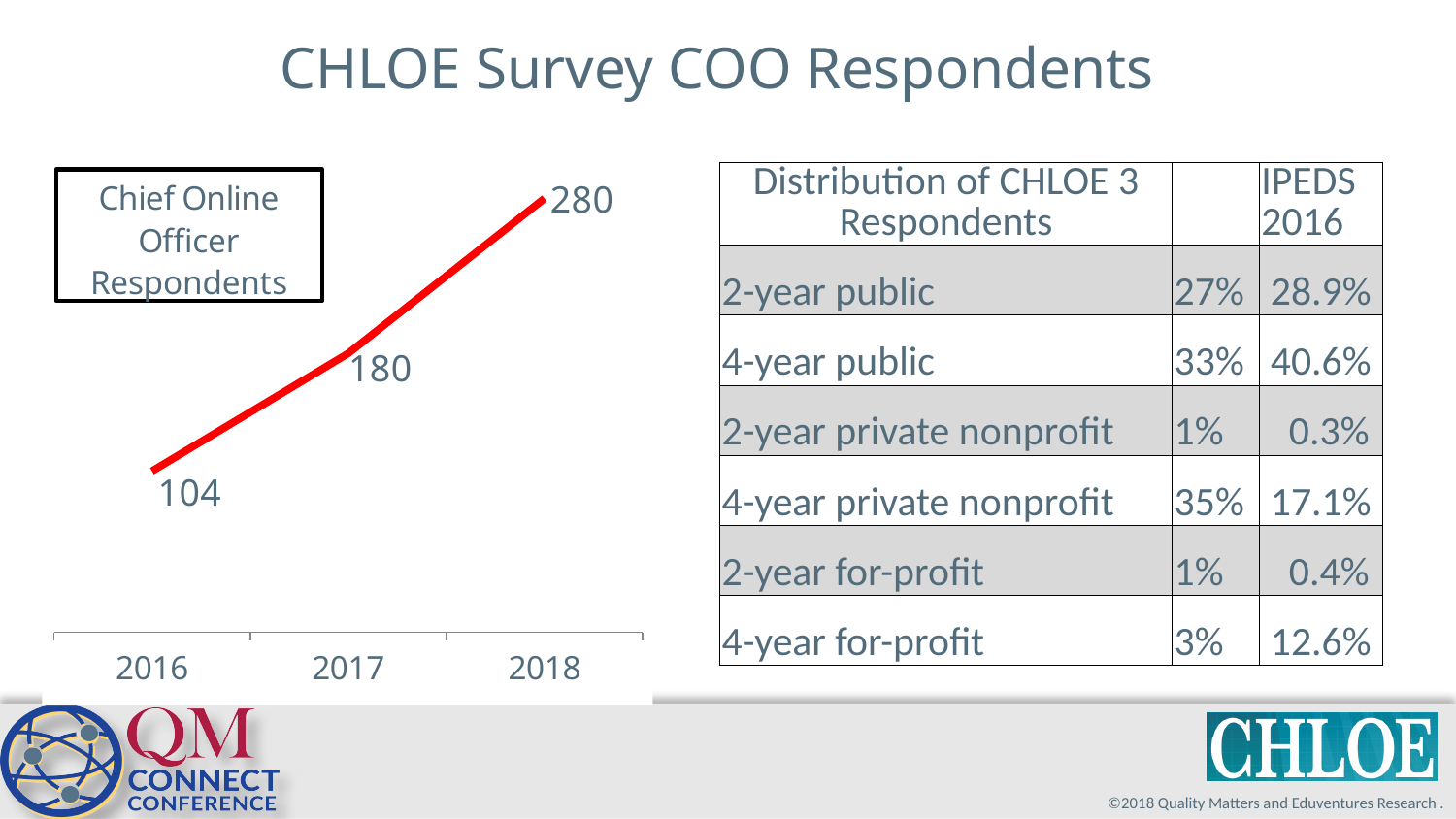
What is the value for 2018 in the Chief Online Officer Respondents chart? 280 How many years are plotted in the Chief Online Officer Respondents chart? 3 Which year has the lowest number of Chief Online Officer respondents? 2016 Do the values in the Chief Online Officer Respondents chart rise or fall from 2016 to 2018? rise What is the value for 2016 in the Chief Online Officer Respondents chart? 104 What is the difference between the 2017 and 2016 values in the Chief Online Officer Respondents chart? 76 What kind of chart is the Chief Online Officer Respondents chart? line chart Which year has the highest number of Chief Online Officer respondents? 2018 What is the value for 2017 in the Chief Online Officer Respondents chart? 180 What is the difference between the 2018 and 2016 values in the Chief Online Officer Respondents chart? 176 What colour is the line in the Chief Online Officer Respondents chart? red In the Chief Online Officer Respondents chart, is the value for 2017 larger or smaller than the value for 2018? smaller